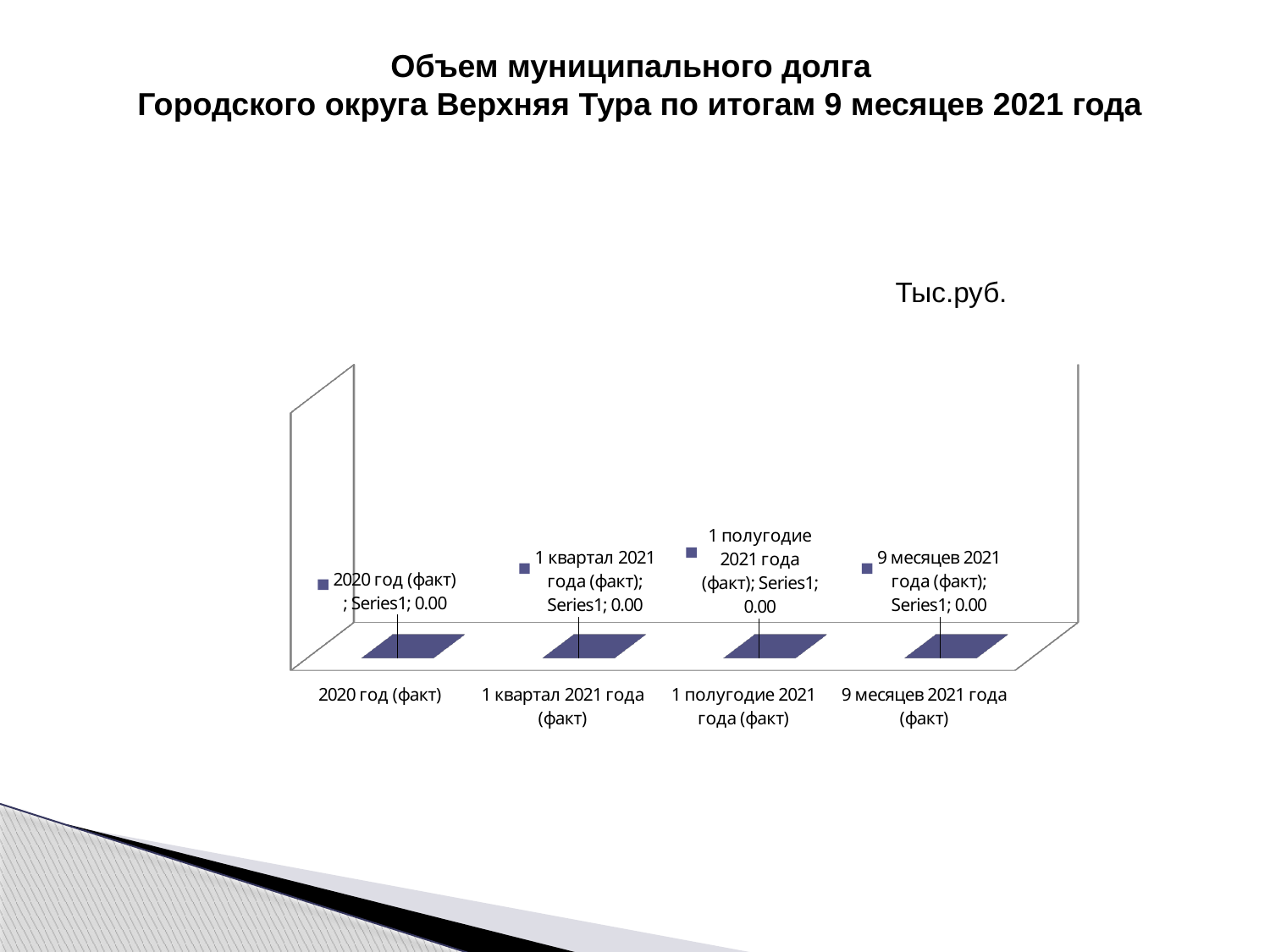
What is the value for 9 месяцев 2021 года (факт)? 0.00 Do the values rise, fall, or stay flat from 2020 год (факт) to 9 месяцев 2021 года (факт)? Stay flat How many categories are shown on the x axis of the chart? 4 What is the difference between the values for 2020 год (факт) and 9 месяцев 2021 года (факт)? 0.00 What unit of measurement is indicated above the chart? Тыс.руб. What kind of chart is shown on the slide? Bar chart What series name appears in the data labels of the chart? Series1 What is the value for 1 квартал 2021 года (факт)? 0.00 What is the value for 1 полугодие 2021 года (факт)? 0.00 What is the value for 2020 год (факт)? 0.00